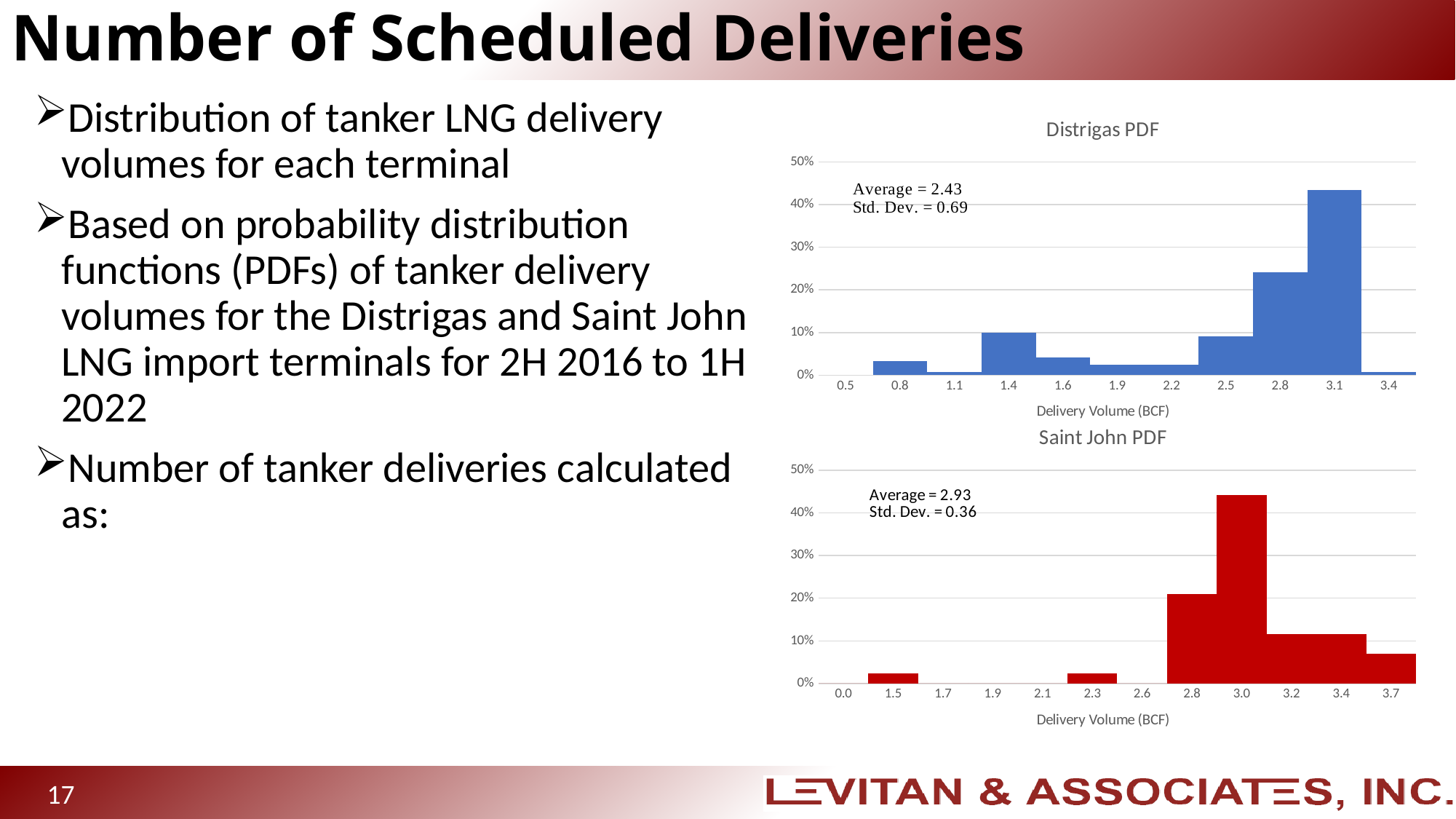
In the Saint John PDF chart, which delivery volume bin has the highest bar? 3.0 What standard deviation is annotated on the Saint John PDF chart? 0.36 In the Distrigas PDF chart, which delivery volume bin has the highest bar? 3.1 How many delivery volume bins are labelled on the x axis of the Distrigas PDF chart? 11 In the Distrigas PDF chart, which bin has the larger value, 1.4 or 1.6? 1.4 In the Distrigas PDF chart, is the value for the 3.1 bin greater or less than 40%? greater In the Distrigas PDF chart, is the value for the 2.8 bin greater or less than 20%? greater In the Saint John PDF chart, which bin has the larger value, 3.2 or 3.7? 3.2 In the Saint John PDF chart, is the value for the 3.0 bin greater or less than 40%? greater What kind of chart is the Distrigas PDF chart? bar chart What average value is annotated on the Distrigas PDF chart? 2.43